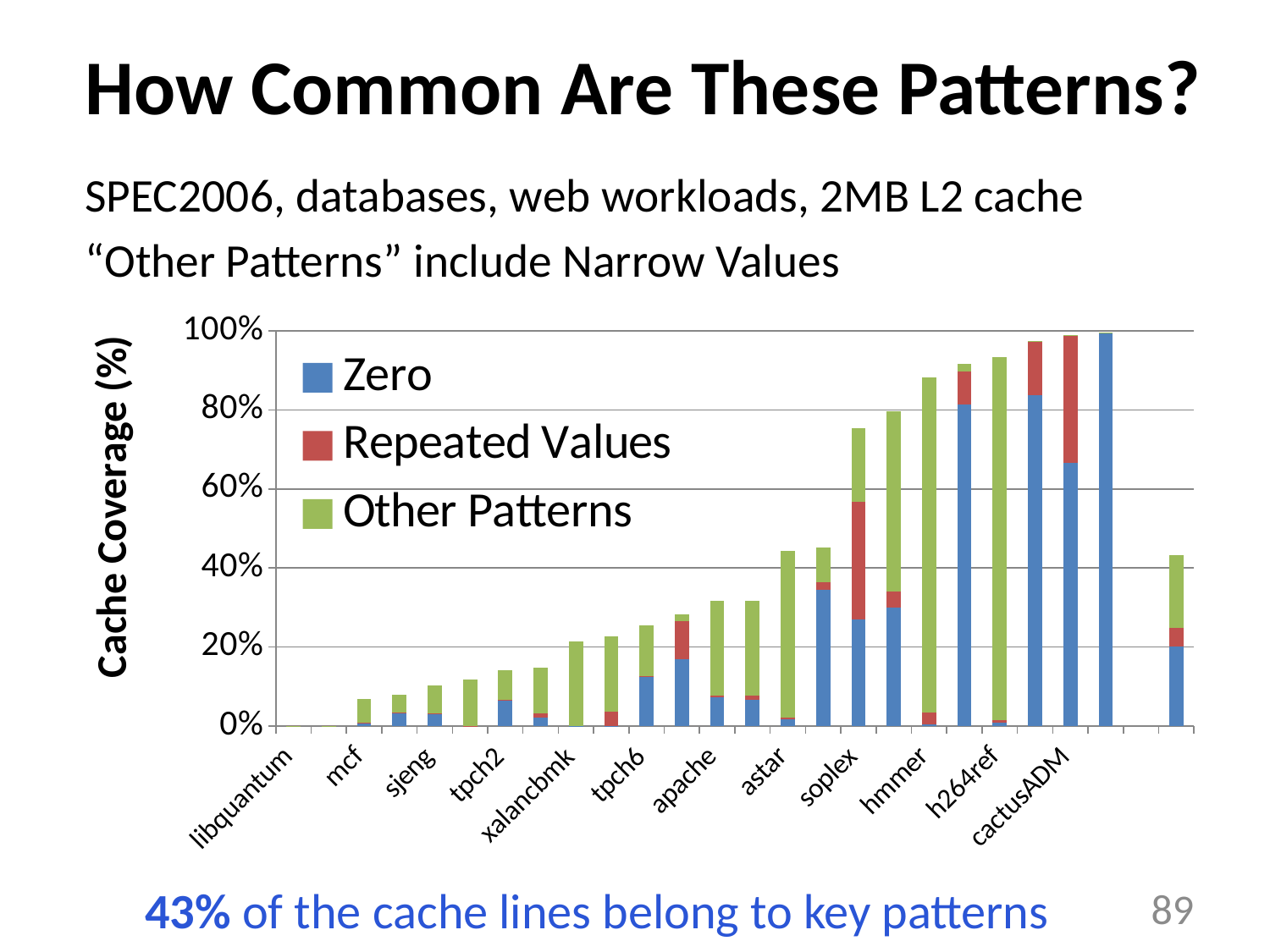
Do the total bar heights generally rise or fall moving from left to right across the workloads? rise Is the total cache coverage for hmmer greater or less than 80%? greater Among the labeled workloads, which has the lowest total cache coverage? libquantum Is the total cache coverage for mcf greater or less than 20%? less What are the three series listed in the chart legend? Zero, Repeated Values, Other Patterns Is the total cache coverage for soplex greater or less than 60%? greater What kind of chart is shown on the slide? stacked bar chart Which has the larger total cache coverage, soplex or apache? soplex How many series does the chart legend list? 3 What is the title of the vertical axis of the chart? Cache Coverage (%)